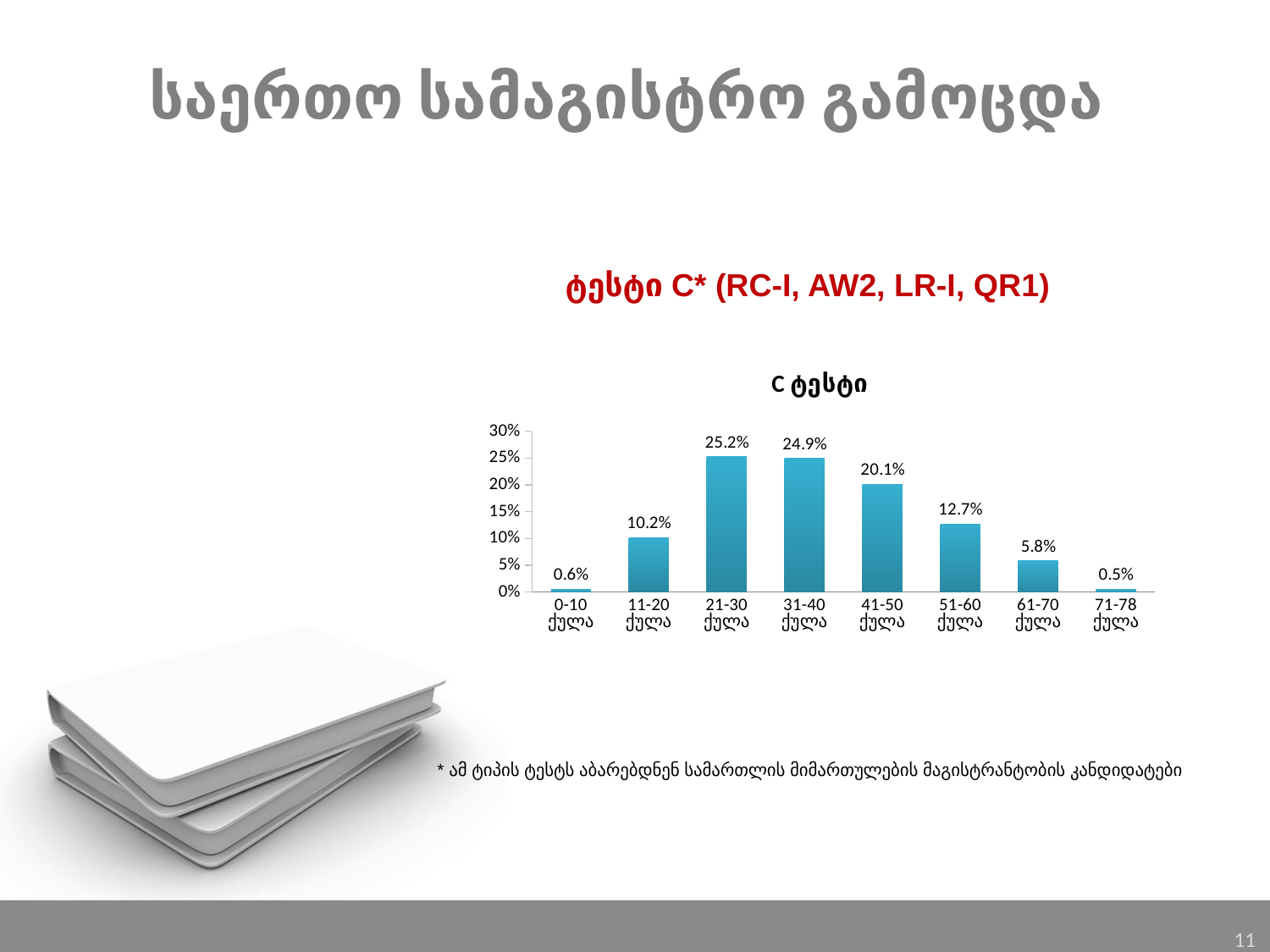
Which category has the highest value? 21-30 ქულა What is the title of the chart? C ტესტი What is the value for the 0-10 ქულა category? 0.6% What is the value for the 21-30 ქულა category? 25.2% Is the value for 31-40 ქულა greater or less than 20%? greater Which is larger, the value for 11-20 ქულა or the value for 51-60 ქულა? 51-60 ქულა Which category has the lowest value? 71-78 ქულა How many score categories are shown on the x axis of the chart? 8 What is the value for the 51-60 ქულა category? 12.7% Do the values rise or fall from 31-40 ქულა to 71-78 ქულა along the x axis? fall What type of chart is shown on the slide? bar chart What is the difference between the values for 41-50 ქულა and 61-70 ქულა? 14.3%